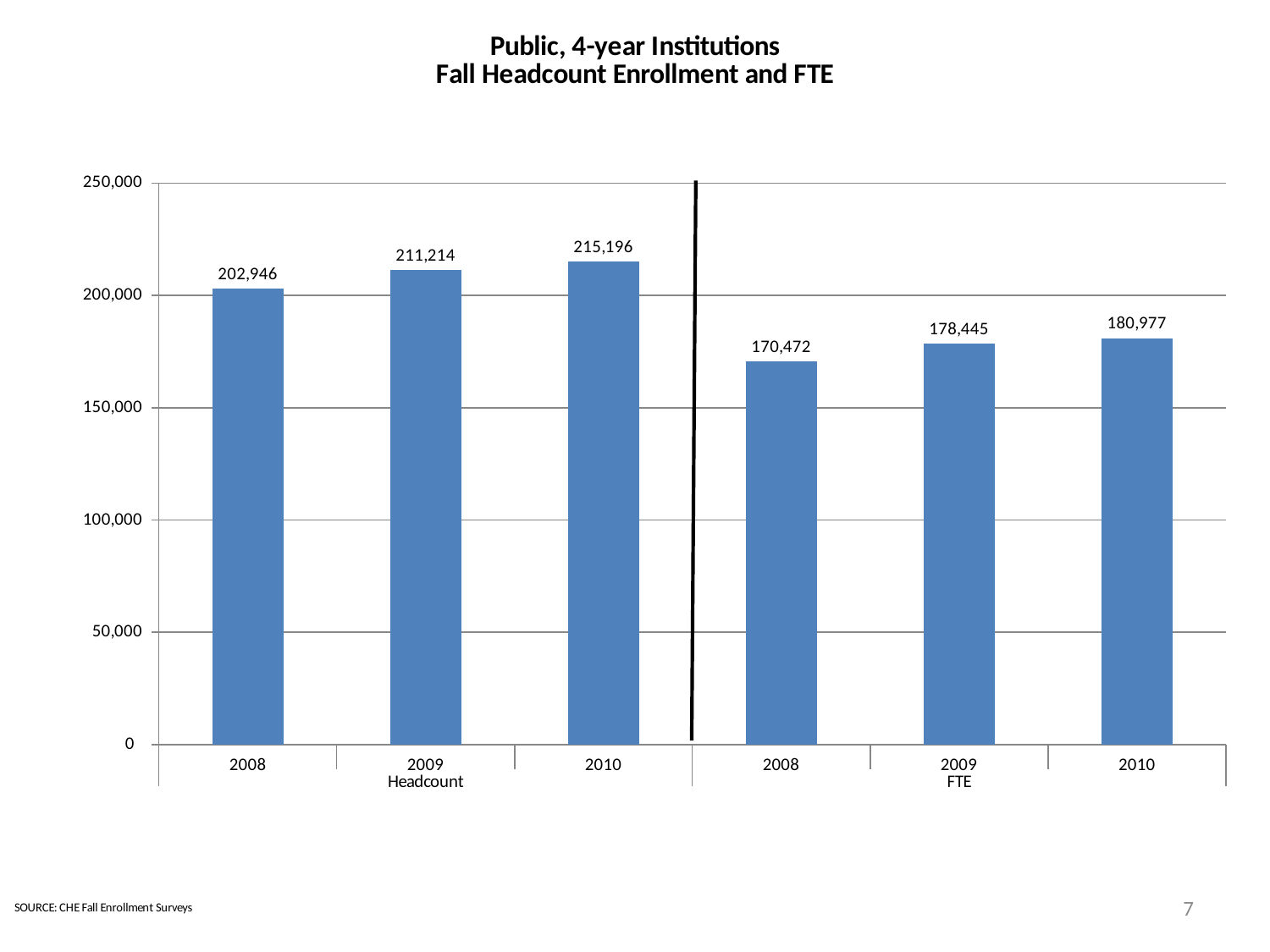
Which year has the highest Headcount? 2010 Which is larger, the Headcount for 2008 or the FTE for 2010? Headcount for 2008 How many bars are plotted in the chart? 6 What kind of chart is shown on the slide? bar chart What is the difference between the FTE for 2009 and the FTE for 2008? 7,973 What is the difference between the Headcount for 2010 and the Headcount for 2008? 12,250 What is the FTE value for 2008? 170,472 Which year has the lowest FTE? 2008 What is the Headcount value for 2010? 215,196 Is the FTE value for 2009 greater or less than 200,000? less What is the Headcount value for 2009? 211,214 What is the FTE value for 2010? 180,977